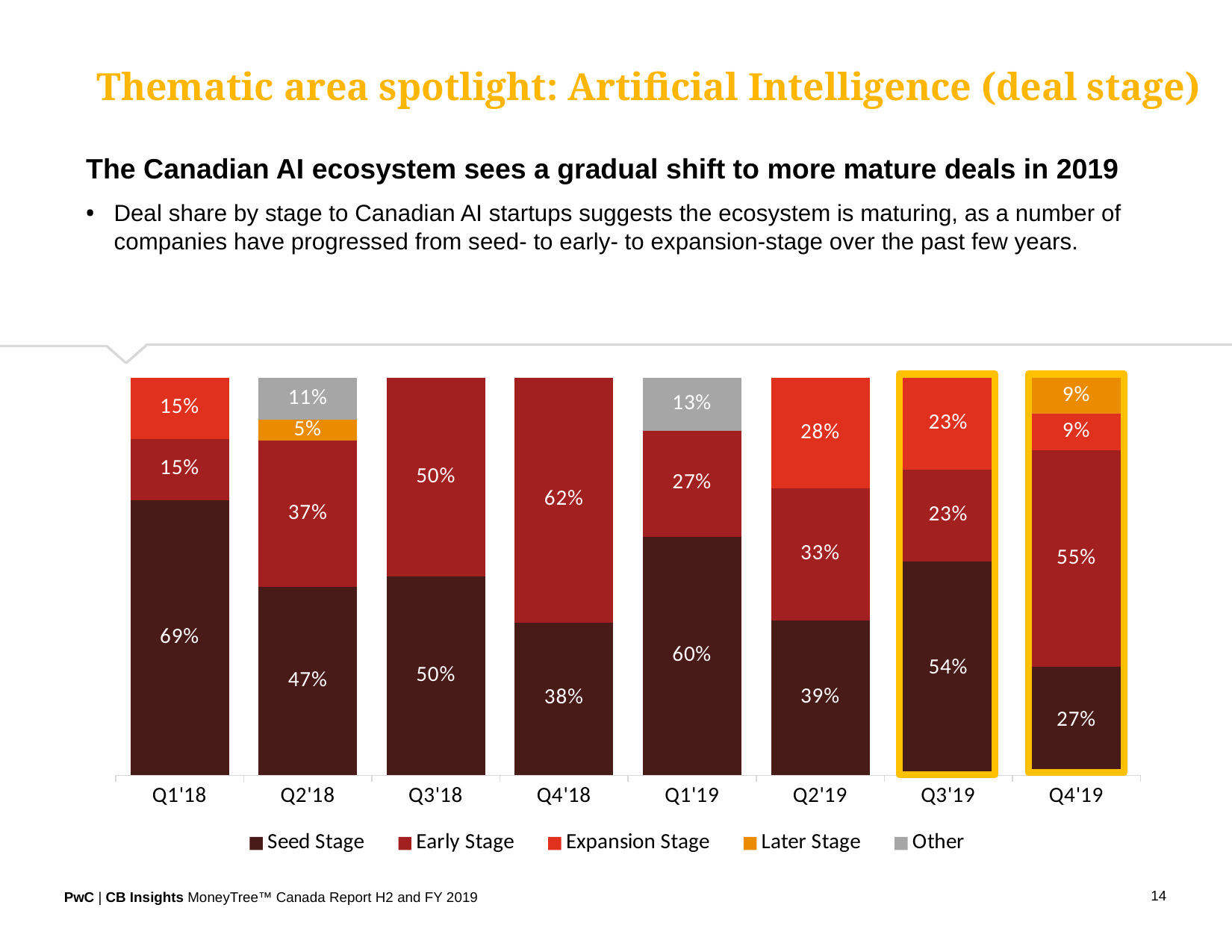
What is the Later Stage share for Q2'18? 5% How many quarters are shown on the x axis? 8 What is the difference between the Seed Stage share in Q3'19 and in Q4'19? 27% How many series does the legend list? 5 What is the Early Stage share for Q4'19? 55% Which quarter has the lowest Seed Stage share? Q4'19 Which is larger in Q2'19: the Seed Stage share or the Early Stage share? Seed Stage What is the Seed Stage share for Q1'18? 69% Which quarter has the highest Seed Stage share? Q1'18 What kind of chart is shown on the slide? Stacked bar chart What is the Expansion Stage share for Q2'19? 28% What is the Other share for Q1'19? 13%